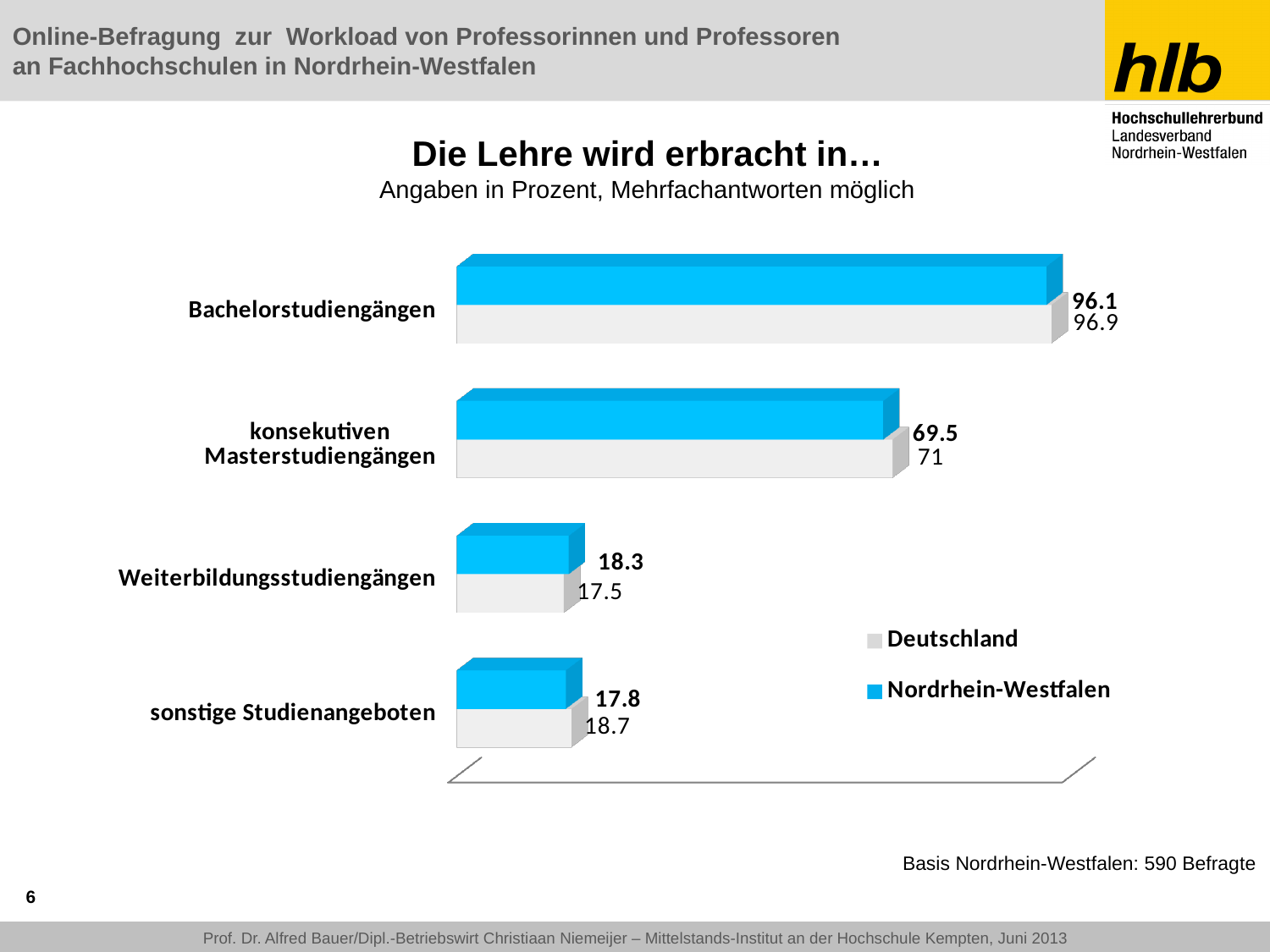
How many categories are shown in the chart? 4 Which series is shown in blue according to the legend? Nordrhein-Westfalen What is the value for Deutschland for sonstige Studienangeboten? 18.7 What kind of chart is shown on the slide? Bar chart For Weiterbildungsstudiengängen, which is larger: the Nordrhein-Westfalen value or the Deutschland value? Nordrhein-Westfalen How many series does the legend list? 2 Which category has the highest value for Nordrhein-Westfalen? Bachelorstudiengängen What is the difference between the Deutschland and Nordrhein-Westfalen values for konsekutiven Masterstudiengängen? 1.5 What is the value for Nordrhein-Westfalen for Weiterbildungsstudiengängen? 18.3 What is the value for Nordrhein-Westfalen for Bachelorstudiengängen? 96.1 Which category has the lowest value for Deutschland? Weiterbildungsstudiengängen What is the value for Deutschland for konsekutiven Masterstudiengängen? 71